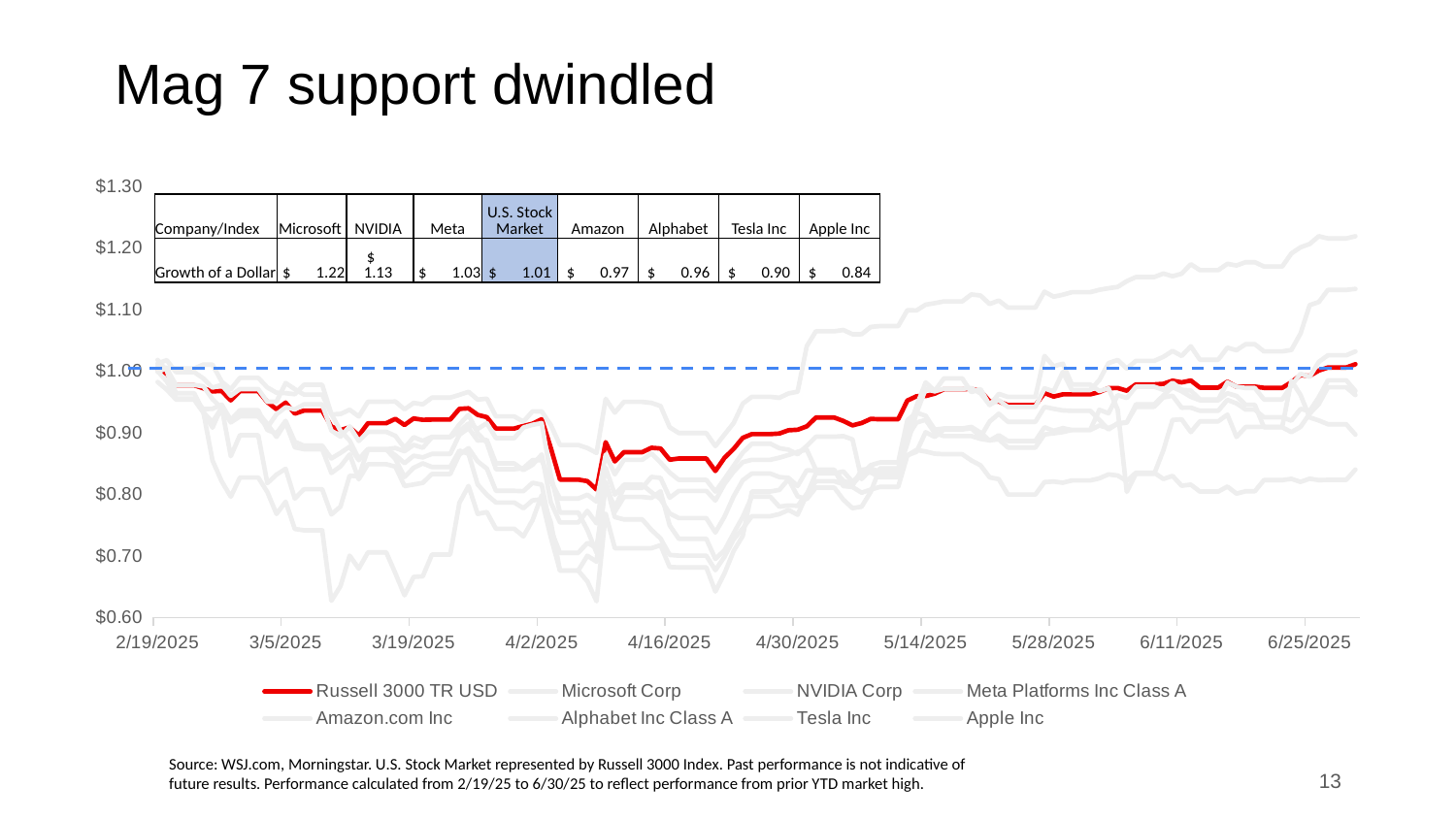
Which company or index in the table has the lowest growth of a dollar value? Apple Inc What is the growth of a dollar value shown for Microsoft in the table? $1.22 What is the growth of a dollar value shown for the U.S. Stock Market in the table? $1.01 Which has a higher growth of a dollar value in the table, NVIDIA or Meta? NVIDIA How many series does the chart legend list? 8 What is the growth of a dollar value shown for Apple Inc in the table? $0.84 Is the value of the Russell 3000 TR USD line around 4/9/2025 greater or less than $0.90? less Which company or index in the table has the highest growth of a dollar value? Microsoft Does the Russell 3000 TR USD line generally rise or fall between 4/30/2025 and 6/25/2025? rise What kind of chart is shown on the slide? Line chart What is the difference between the growth of a dollar values for Microsoft and Apple Inc in the table? $0.38 What is the title of the slide? Mag 7 support dwindled